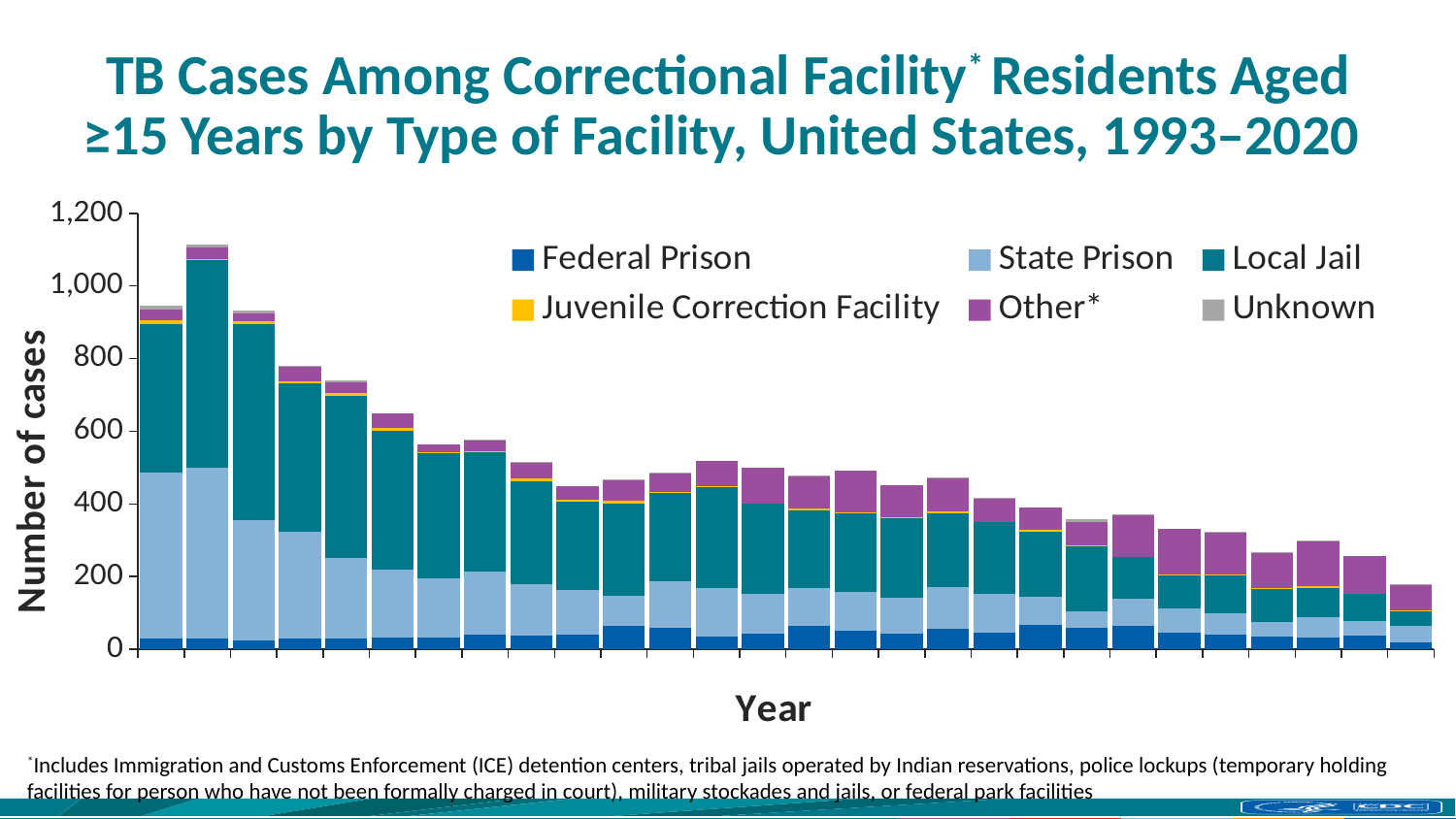
Which bar has the lowest total number of cases? The rightmost bar How many bars (years) are plotted in the chart? 28 Is the total number of cases for the second bar from the left greater or less than 1,000? greater Is the total number of cases for the leftmost bar greater or less than 800? greater Which series is shown in dark teal in the legend? Local Jail Which bar has the highest total number of cases: the leftmost bar or the second bar from the left? The second bar from the left Overall, do the total number of cases rise or fall from left to right across the years? Fall Which bar has the highest total number of cases? The second bar from the left Is the total number of cases for the rightmost bar greater or less than 200? less What is the label of the vertical axis? Number of cases What kind of chart is shown on the slide? Stacked bar chart How many series does the legend list? 6